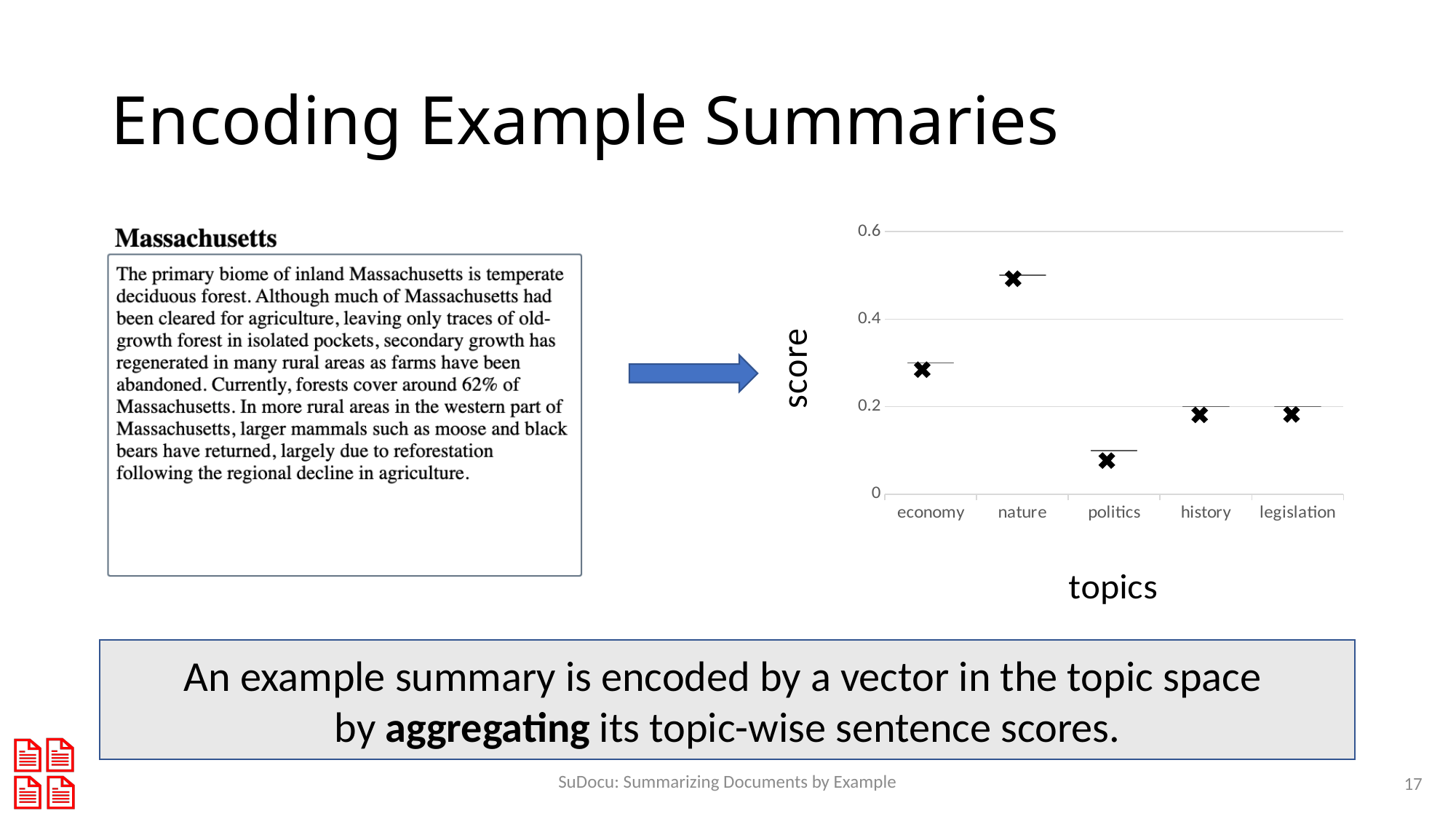
Is the score for nature greater or less than 0.4? greater Is the score for nature greater or less than 0.6? less Which topic has the highest score in the chart? nature Is the score for politics greater or less than 0.2? less What is the label of the vertical axis of the chart? score Which topic has the lowest score in the chart? politics Which has a higher score, economy or nature? nature What is the label of the horizontal axis of the chart? topics What kind of chart is shown on the slide? scatter chart How many topics are plotted on the x axis of the chart? 5 Which has a higher score, politics or history? history